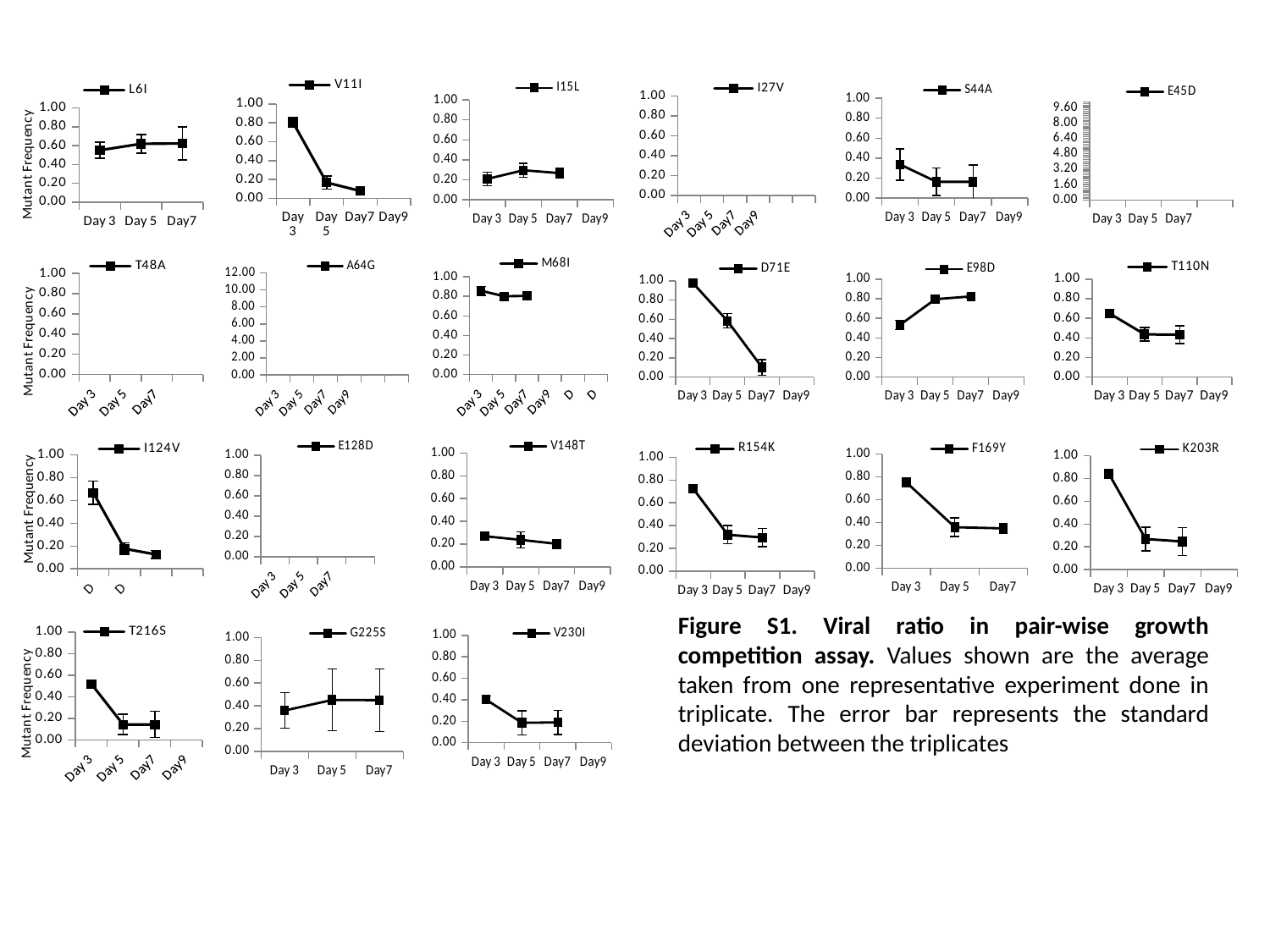
How many data points are plotted in the L6I chart? 3 In the I124V chart, which is larger, the first point or the second point? the first point In the F169Y chart, is the value for Day 5 greater or less than 0.60? less In the T216S chart, which day has the highest value? Day 3 In the V11I chart, do the values rise or fall from Day 3 to Day 7? fall In the E98D chart, do the values rise or fall from Day 3 to Day 7? rise How many series does the legend of the M68I chart list? 1 In the V11I chart, is the value for Day7 greater or less than 0.20? less What is the y-axis label on the L6I chart? Mutant Frequency What kind of chart is the V11I chart? line chart In the K203R chart, is the value for Day 3 greater or less than 0.60? greater